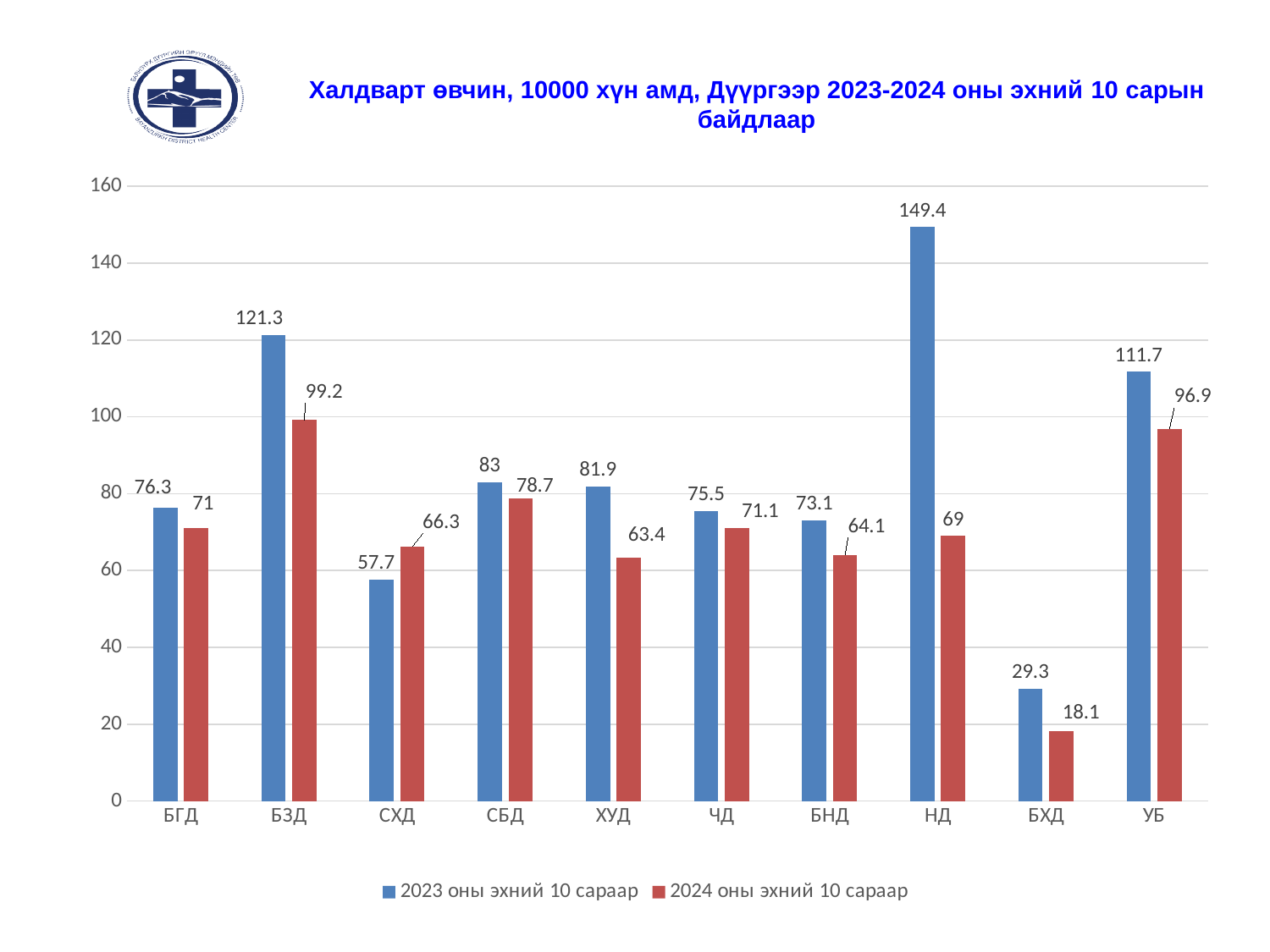
Is the value for УБ in the 2023 оны эхний 10 сараар series greater or less than 100? greater What colour are the bars for the 2024 оны эхний 10 сараар series? red How many series does the legend list? 2 Which category has the highest value in the 2023 оны эхний 10 сараар series? НД How many categories are shown on the x axis? 10 What is the value for НД in the 2023 оны эхний 10 сараар series? 149.4 Which category has the lowest value in the 2024 оны эхний 10 сараар series? БХД What is the value for СХД in the 2023 оны эхний 10 сараар series? 57.7 What kind of chart is shown on the slide? bar chart What is the difference between the 2023 and 2024 values for НД? 80.4 What is the value for БЗД in the 2024 оны эхний 10 сараар series? 99.2 Which is larger for СХД: the 2023 оны эхний 10 сараар value or the 2024 оны эхний 10 сараар value? 2024 оны эхний 10 сараар